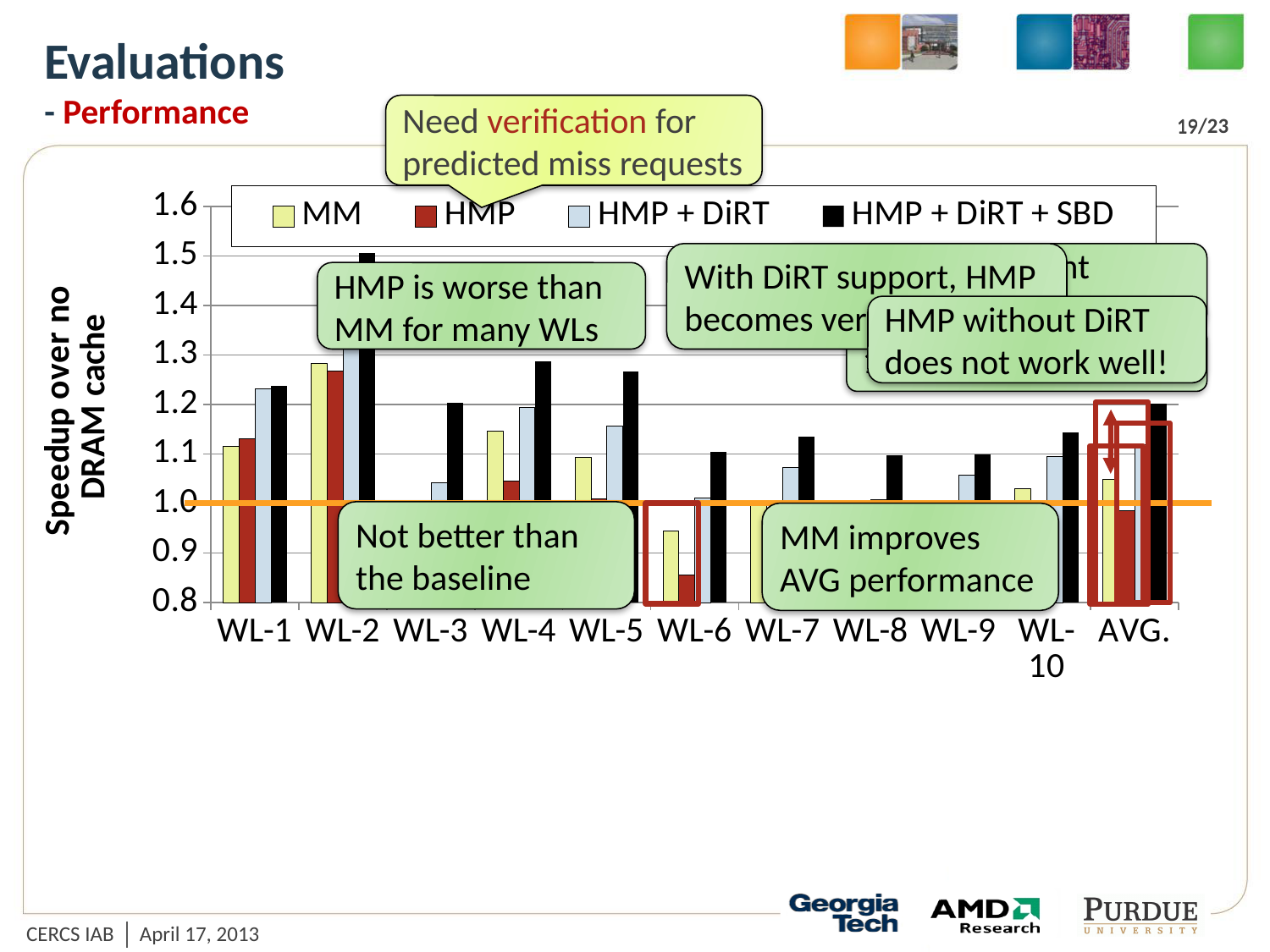
How many series does the legend list? 4 Is the HMP + DiRT value for WL-9 greater or less than 1.0? greater How many categories are shown along the x axis? 11 What is the y-axis title of the chart? Speedup over no DRAM cache For WL-5, which is larger, the HMP + DiRT value or the HMP + DiRT + SBD value? HMP + DiRT + SBD Is the MM value for WL-6 greater or less than 1.0? less What kind of chart is shown on the slide? bar chart Is the HMP value for WL-6 greater or less than 0.9? less For WL-4, which is larger, the MM value or the HMP value? MM Which series is shown in black in the legend? HMP + DiRT + SBD